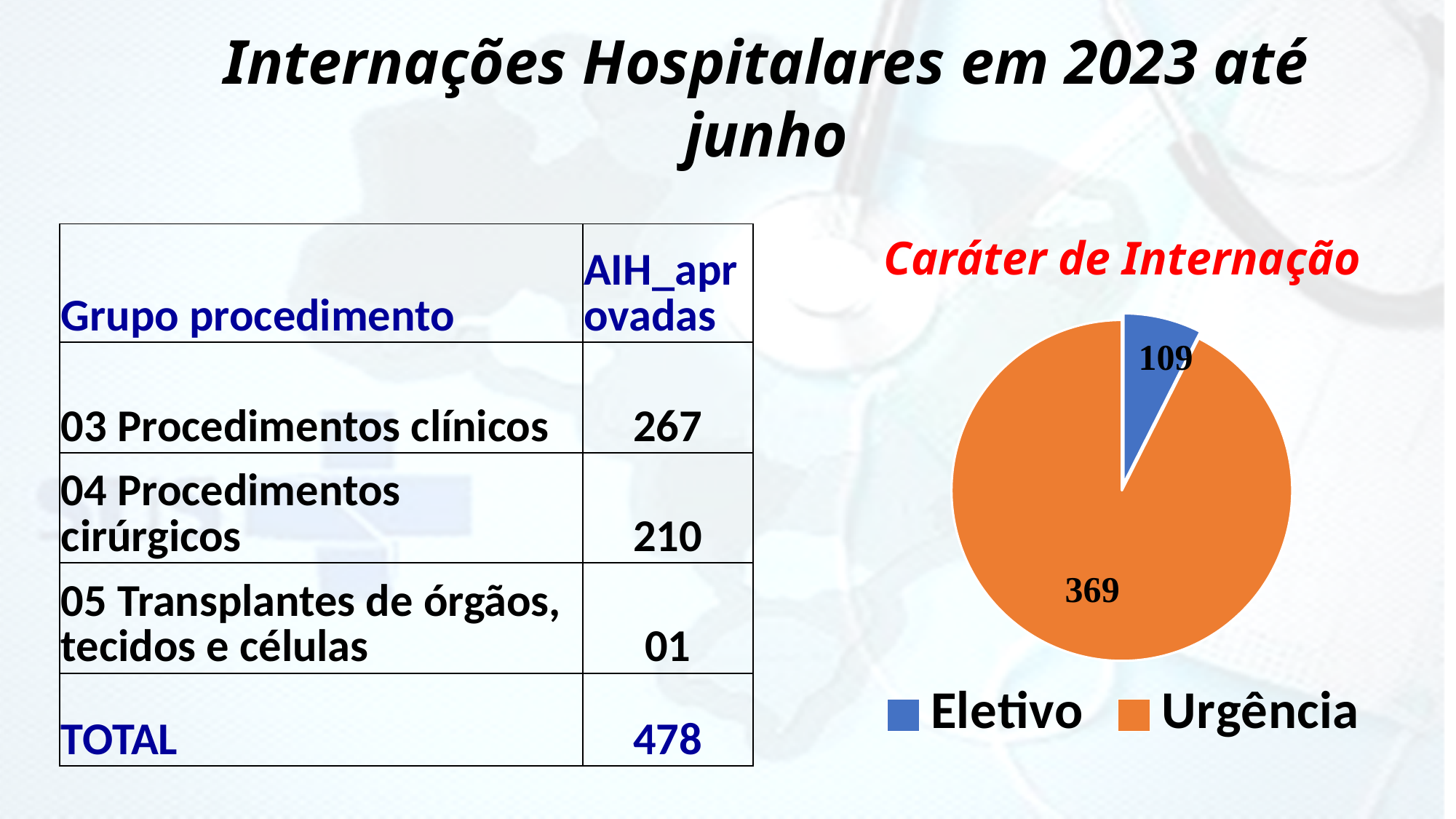
How many entries does the pie chart legend list? 2 Which category in the pie chart has the smallest value? Eletivo In the pie chart, what is the value for Urgência? 369 Which category in the pie chart has the largest value? Urgência Which colour represents Urgência in the pie chart? orange What is the total of the two slices in the pie chart? 478 In the pie chart, which is larger, Eletivo or Urgência? Urgência What is the difference between the Urgência and Eletivo values in the pie chart? 260 How many slices does the pie chart have? 2 In the pie chart, what is the value for Eletivo? 109 What is the title of the pie chart? Caráter de Internação What kind of chart is shown on the right of the slide? pie chart